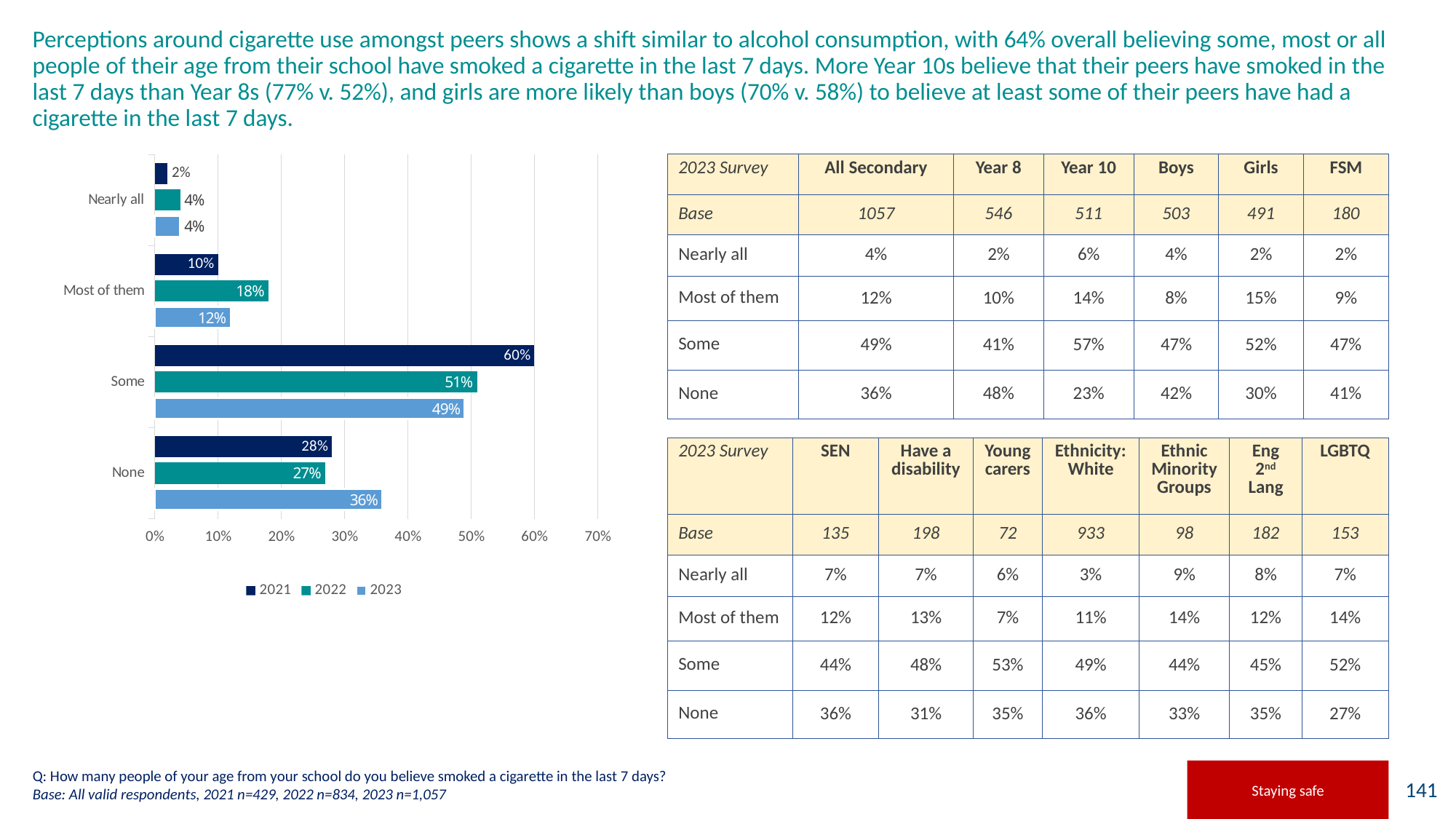
What is the 2022 value for 'Most of them' in the chart? 18% Is the 2022 value for 'Some' in the chart greater or less than 40%? greater What is the 2023 value for 'Some' in the chart? 49% What is the difference between the 2021 and 2023 values for 'Some' in the chart? 11% What is the 2021 value for 'None' in the chart? 28% Which series in the chart legend is shown in the darkest blue colour? 2021 Which category has the lowest 2023 value in the chart? Nearly all How many series does the chart legend list? 3 Which is larger in the chart: the 2023 value for 'None' or the 2021 value for 'None'? 2023 How many categories are shown on the chart's vertical axis? 4 Which category has the highest 2021 value in the chart? Some What kind of chart is shown on the slide? Bar chart